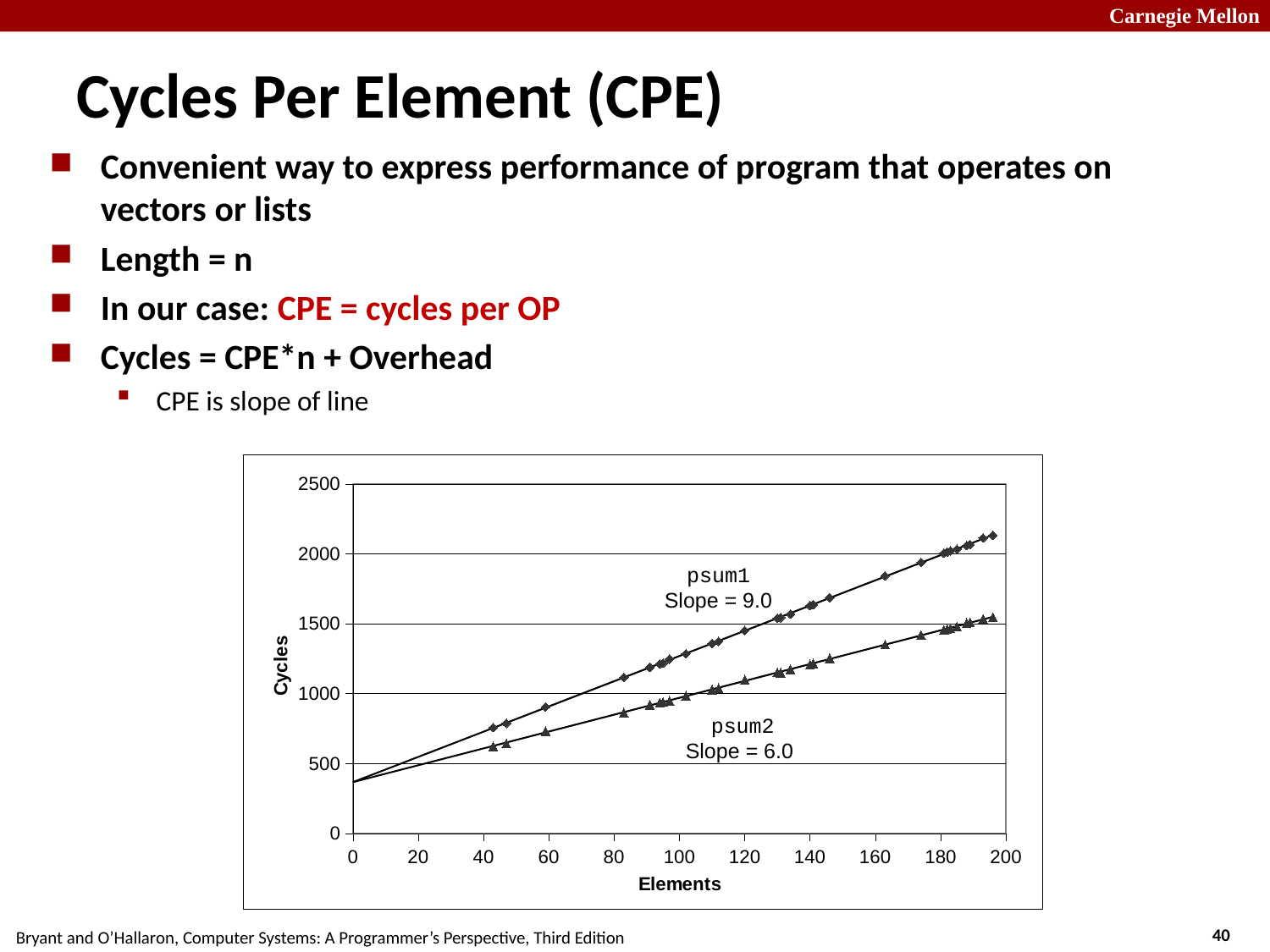
What is the slope printed for the psum2 series? 6.0 What is the difference between the printed slopes of psum1 and psum2? 3.0 Is the value for psum1 at about 100 elements greater or less than 1000 cycles? greater At 160 elements, which series has more cycles, psum1 or psum2? psum1 What is the label on the y axis of the chart? Cycles Is the value for psum1 at about 195 elements greater or less than 2000 cycles? greater Which series has the steeper slope, psum1 or psum2? psum1 Do the cycles for psum2 rise or fall as the number of elements increases? rise What kind of chart is shown on the slide? scatter chart What is the slope printed for the psum1 series? 9.0 What is the label on the x axis of the chart? Elements